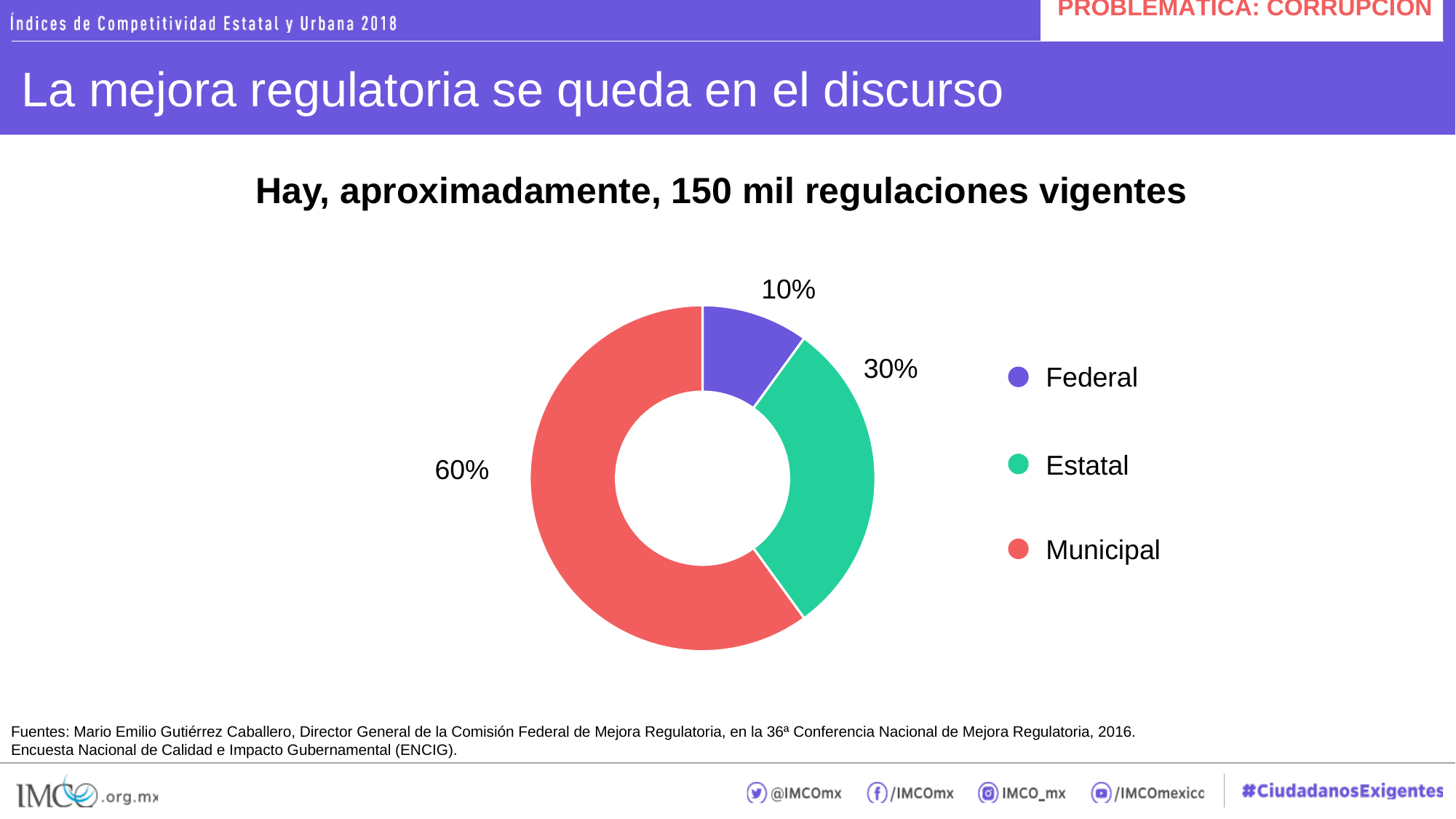
What is the difference in percentage points between the Estatal and Federal shares? 20 What is the difference in percentage points between the Municipal and Estatal shares? 30 What colour represents Municipal in the chart? Red What kind of chart is shown on the slide? Pie chart (donut) Which category has the largest share of the pie? Municipal What is the heading above the chart? Hay, aproximadamente, 150 mil regulaciones vigentes Which category has the smallest share of the pie? Federal What share of the regulations is Federal? 10% Which is larger, the Estatal share or the Federal share? Estatal How many categories does the chart show? 3 What share of the regulations is Municipal? 60% What share of the regulations is Estatal? 30%